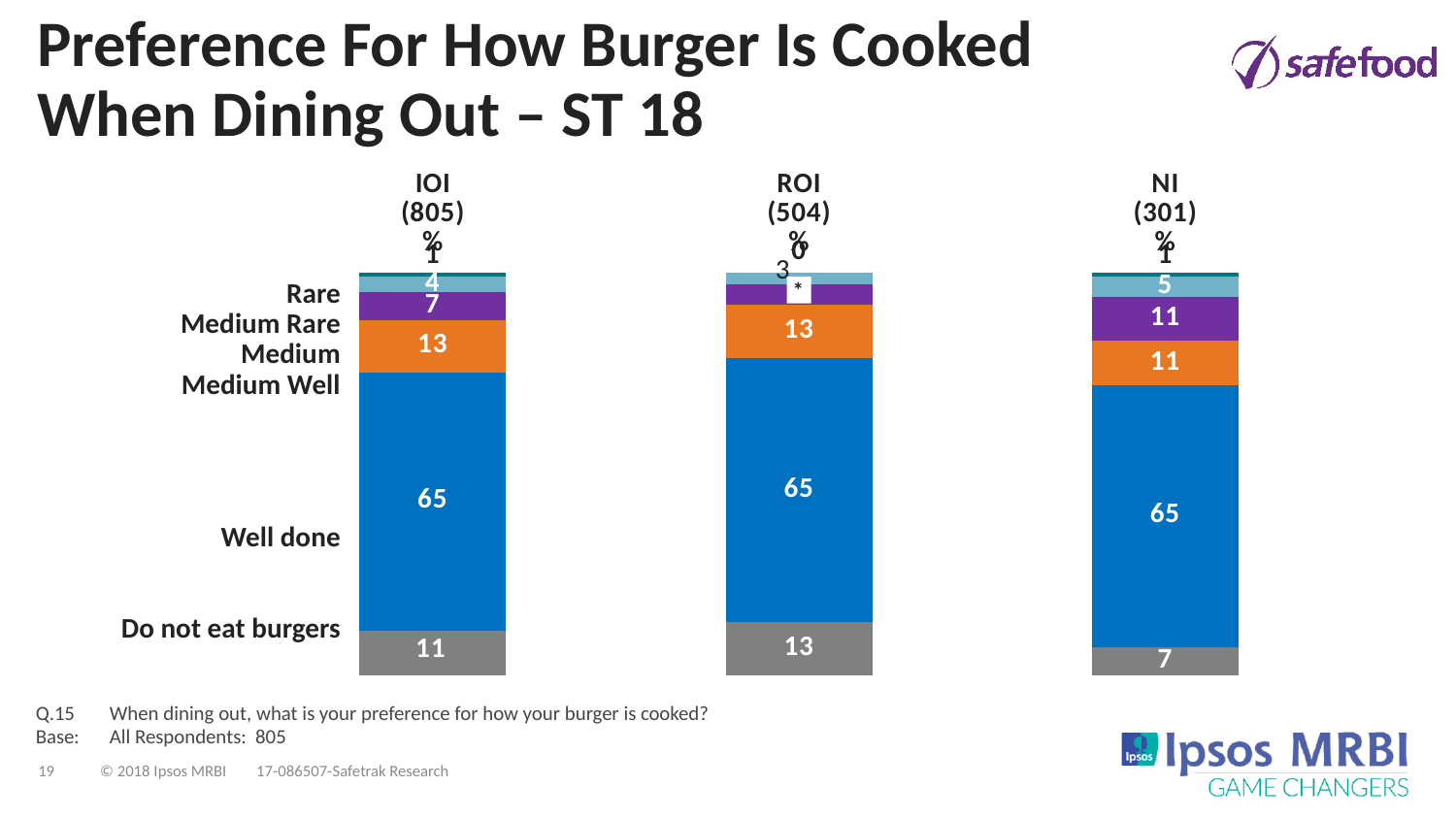
What percentage of NI respondents prefer their burger medium? 11 What type of chart is used on this slide? Stacked bar chart Which is larger: the 'Medium' percentage for NI or for IOI? NI Which preference category has the largest share in the ROI bar? Well done What percentage of NI respondents do not eat burgers? 7 What is the base size shown for the ROI bar? 504 What is the difference between the 'Do not eat burgers' percentages for ROI and NI? 6 What percentage of IOI respondents prefer their burger well done? 65 What percentage of ROI respondents do not eat burgers? 13 What percentage of IOI respondents prefer their burger medium well? 13 How many regional bars are shown on the chart? 3 What is the difference between the 'Medium Well' percentages for IOI and NI? 2